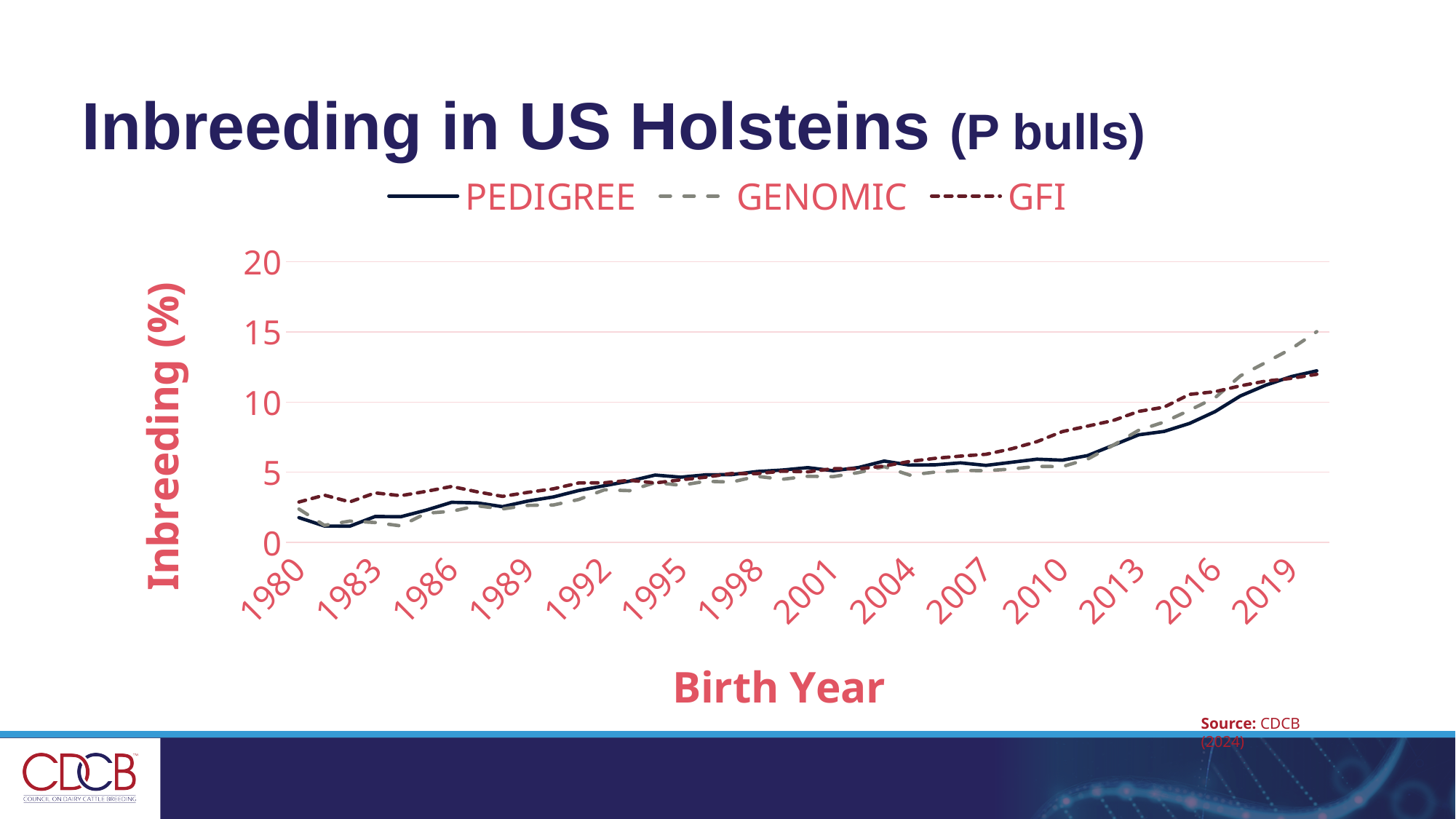
At 1980, which series has the higher value, GFI or PEDIGREE? GFI Do the PEDIGREE values rise or fall from 1980 to 2019? Rise Is the PEDIGREE value at 1980 greater or less than 5? less How many birth-year labels are shown on the x axis? 14 At 2019, which series has the higher value, GENOMIC or PEDIGREE? GENOMIC Is the GFI value at 2010 greater or less than 5? greater What is the label of the y axis? Inbreeding (%) Is the GENOMIC value at 2019 greater or less than 10? greater What kind of chart is shown on the slide? Line chart How many series does the legend list? 3 What is the title of the chart on the slide? Inbreeding in US Holsteins (P bulls)